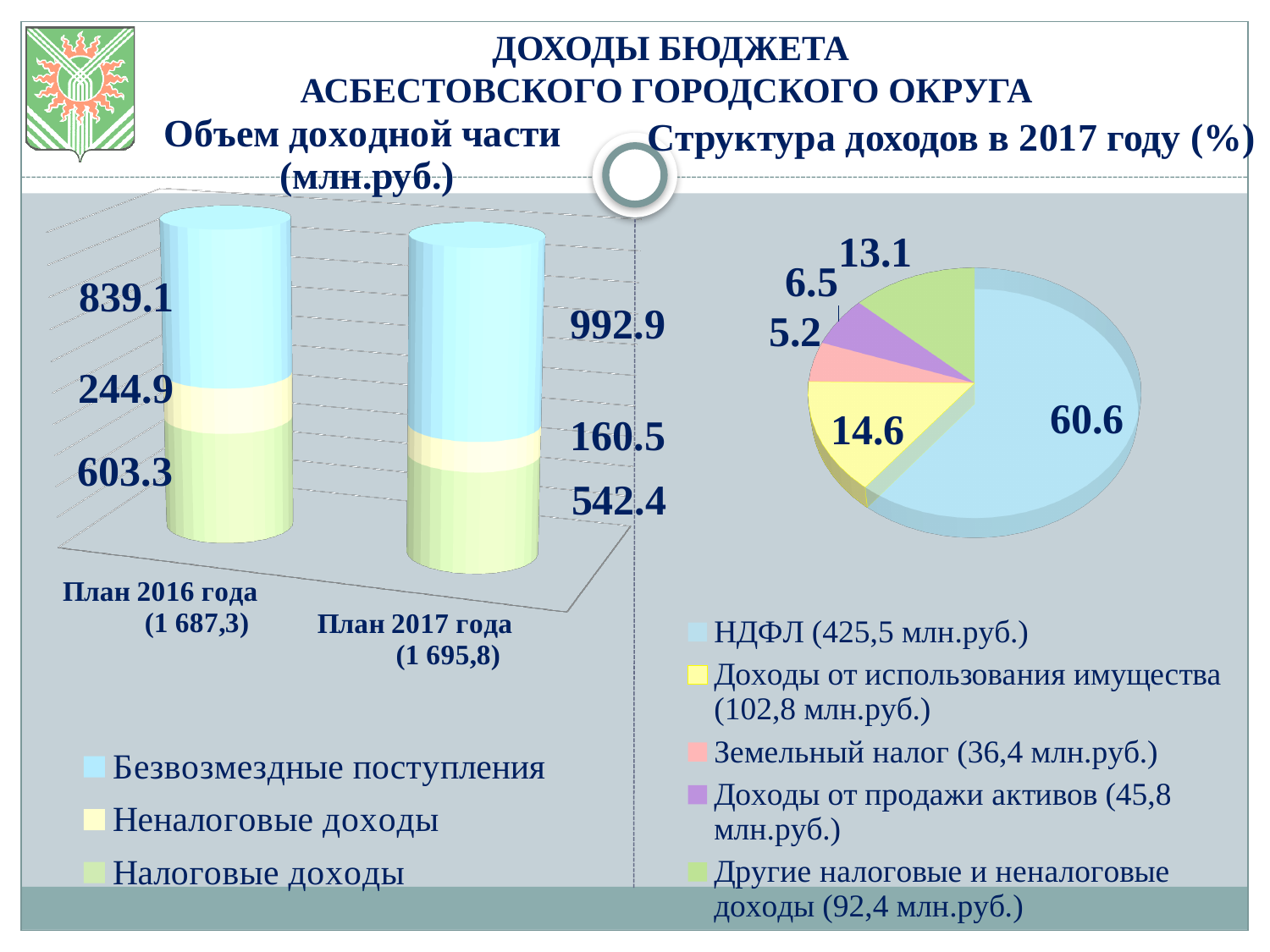
In the chart 'Объем доходной части (млн.руб.)', by how much did Безвозмездные поступления change from План 2016 года to План 2017 года? 153.8 In the chart 'Объем доходной части (млн.руб.)', what is the value of Налоговые доходы for План 2016 года? 603.3 In the pie chart 'Структура доходов в 2017 году (%)', what is the difference between the shares of Доходы от использования имущества and Другие налоговые и неналоговые доходы? 1.5 In the pie chart 'Структура доходов в 2017 году (%)', how many slices are there? 5 In the chart 'Объем доходной части (млн.руб.)', what is the total shown for План 2017 года? 1 695,8 In the chart 'Объем доходной части (млн.руб.)', which is larger: Налоговые доходы for План 2016 года or for План 2017 года? План 2016 года In the pie chart 'Структура доходов в 2017 году (%)', which category has the smallest share? Земельный налог In the pie chart 'Структура доходов в 2017 году (%)', what share does НДФЛ have? 60.6 In the chart 'Объем доходной части (млн.руб.)', what is the value of Безвозмездные поступления for План 2017 года? 992.9 In the chart 'Объем доходной части (млн.руб.)', what is the value of Неналоговые доходы for План 2017 года? 160.5 What kind of chart is 'Объем доходной части (млн.руб.)'? Stacked bar chart In the chart 'Объем доходной части (млн.руб.)', how many series does the legend list? 3